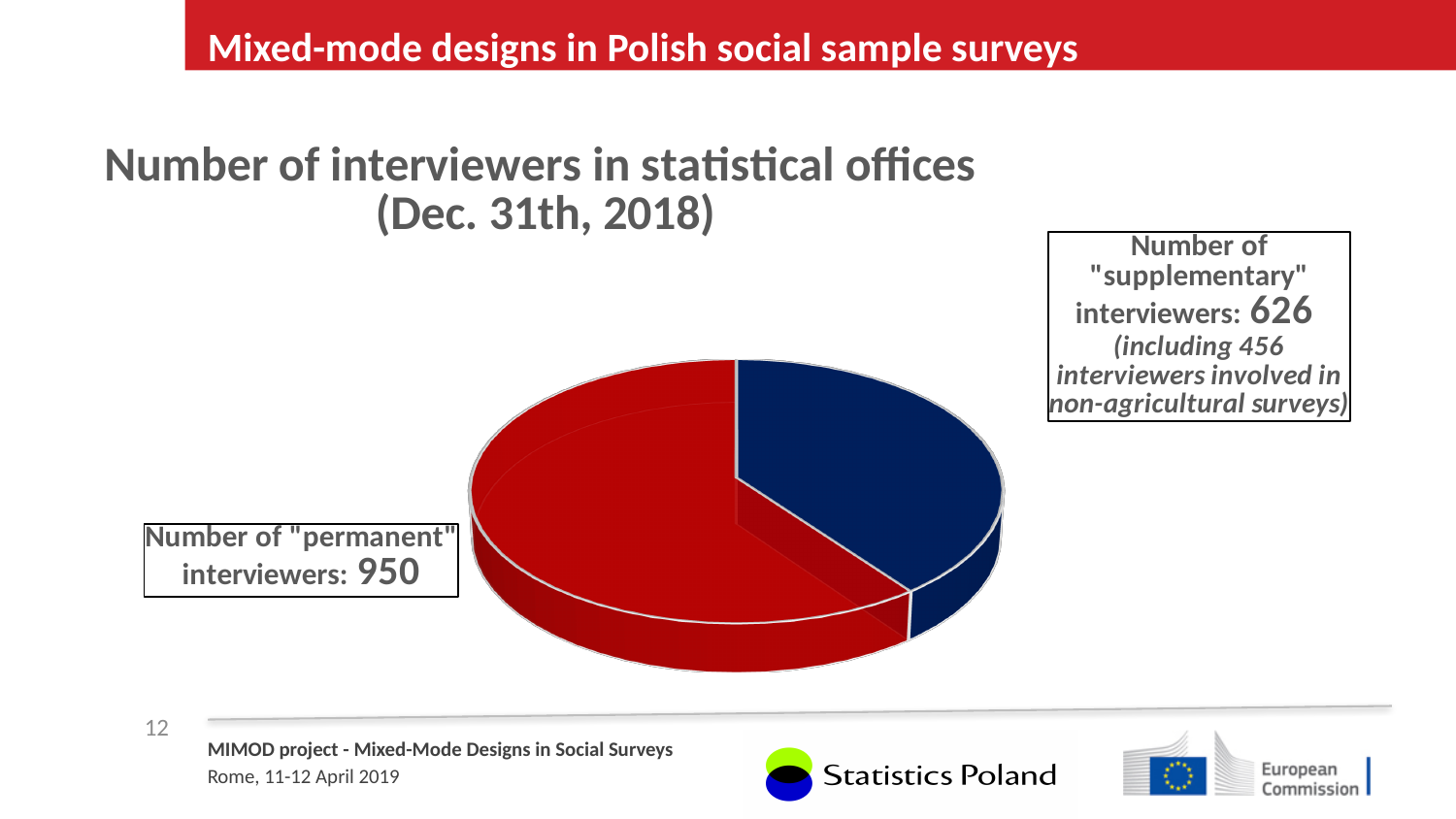
What kind of chart is shown on the slide? pie chart What colour is the slice representing "permanent" interviewers? red Which group of interviewers is larger, "permanent" or "supplementary"? permanent What is the total number of interviewers represented in the pie chart? 1576 What is the number of "supplementary" interviewers shown on the chart? 626 How many slices does the pie chart have? 2 What is the difference between the number of "permanent" interviewers and the number of "supplementary" interviewers? 324 How many of the supplementary interviewers are involved in non-agricultural surveys? 456 What is the title of the chart? Number of interviewers in statistical offices (Dec. 31th, 2018) Which slice of the pie chart is the smallest? Number of "supplementary" interviewers What is the number of "permanent" interviewers shown on the chart? 950 Which slice of the pie chart is the largest? Number of "permanent" interviewers